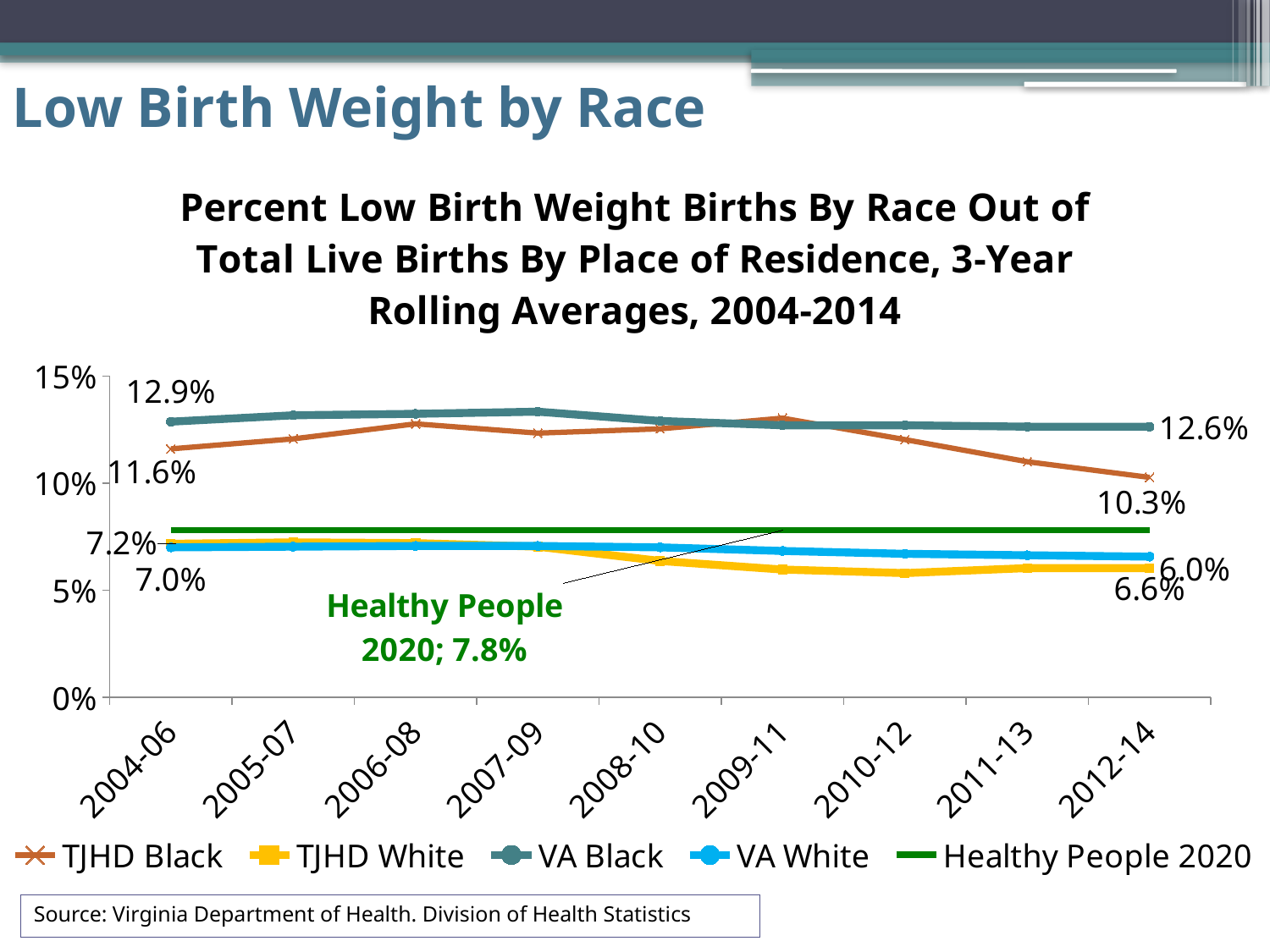
By how many percentage points did TJHD Black change from 2004-06 (11.6%) to 2012-14 (10.3%)? 1.3 percentage points Does the TJHD Black line rise or fall overall from 2004-06 to 2012-14? Fall What type of chart is shown on the slide? Line chart How many series does the legend list? 5 What is the value for TJHD Black in 2012-14? 10.3% Which series has the highest value in 2012-14? VA Black What is the value for VA Black in 2004-06? 12.9% What is the Healthy People 2020 target shown on the chart? 7.8% Is the value for VA Black in 2007-09 greater or less than 10%? greater What is the difference between VA Black and TJHD Black in 2012-14? 2.3 percentage points How many 3-year periods are shown on the x axis? 9 What is the value for VA Black in 2012-14? 12.6%